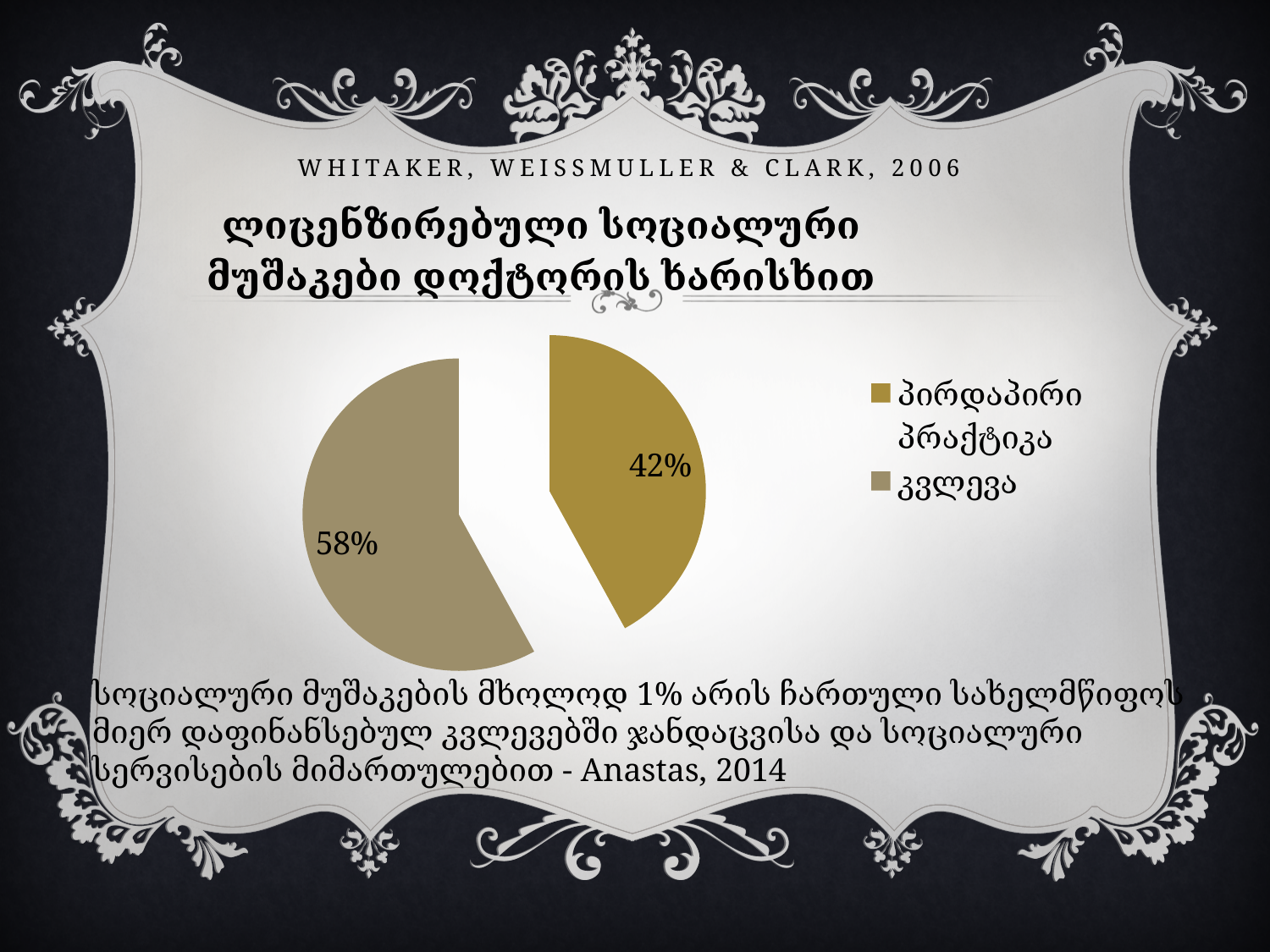
Which slice of the pie is the smallest? პირდაპირი პრაქტიკა What is the difference in percentage points between კვლევა and პირდაპირი პრაქტიკა? 16 What kind of chart is shown on the slide? pie chart How many slices does the pie chart have? 2 Which legend entry is shown in the gold colour? პირდაპირი პრაქტიკა Which is larger, the share for კვლევა or the share for პირდაპირი პრაქტიკა? კვლევა What is the title of the chart? ლიცენზირებული სოციალური მუშაკები დოქტორის ხარისხით What is the total of the two slices shown in the pie chart? 100% How many entries does the legend list? 2 Which slice of the pie is the largest? კვლევა What share of the pie does კვლევა represent? 58% What share of the pie does პირდაპირი პრაქტიკა represent? 42%